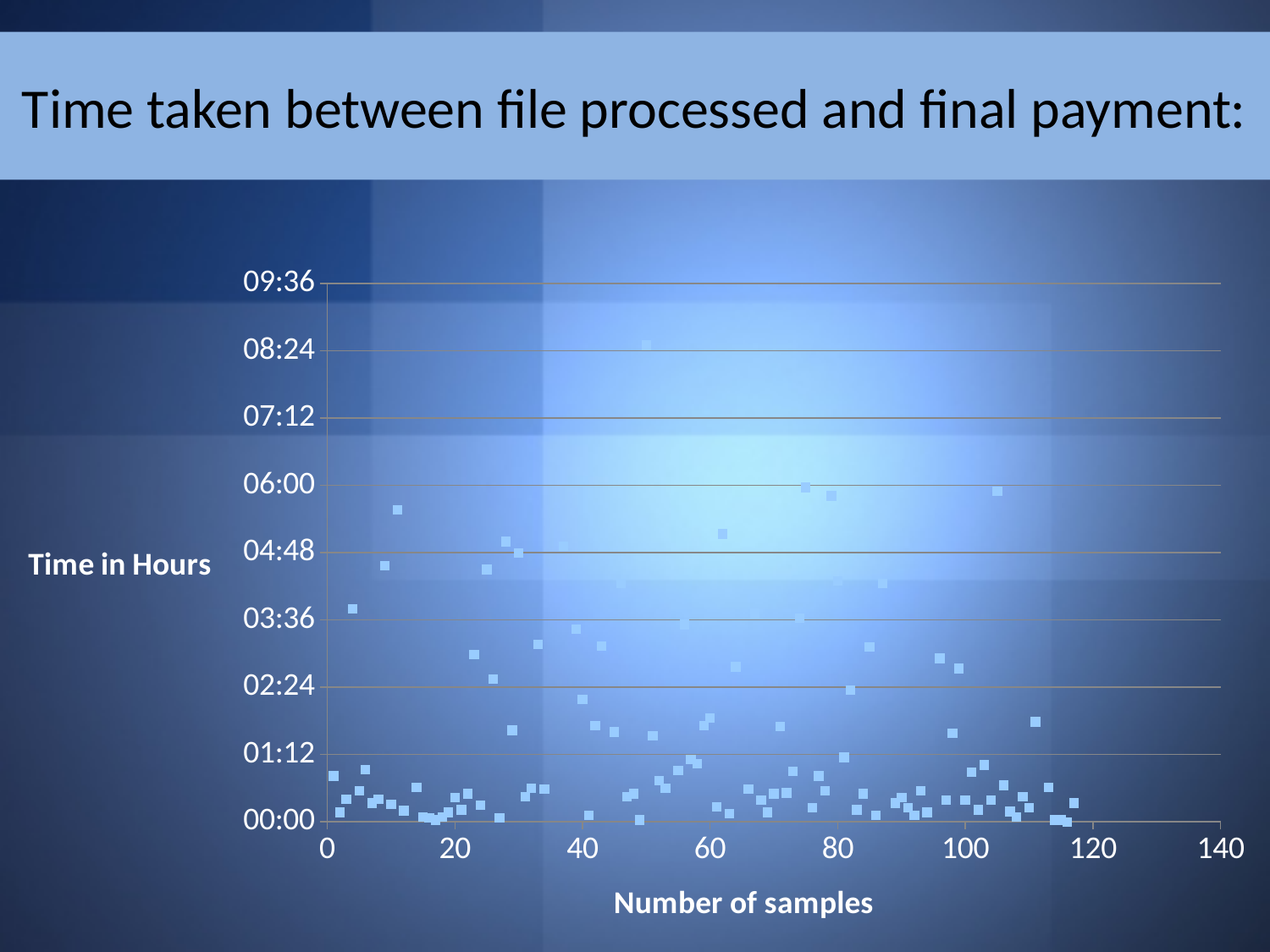
Is the highest plotted point on the chart greater or less than 09:36? less Is the highest plotted point on the chart greater or less than 07:12? greater What is the label of the x axis of the chart? Number of samples What kind of chart is shown on the slide? scatter chart Is the value of the point plotted near x = 10 (the one above 04:48) greater or less than 06:00? less What is the title of the chart on the slide? Time taken between file processed and final payment: